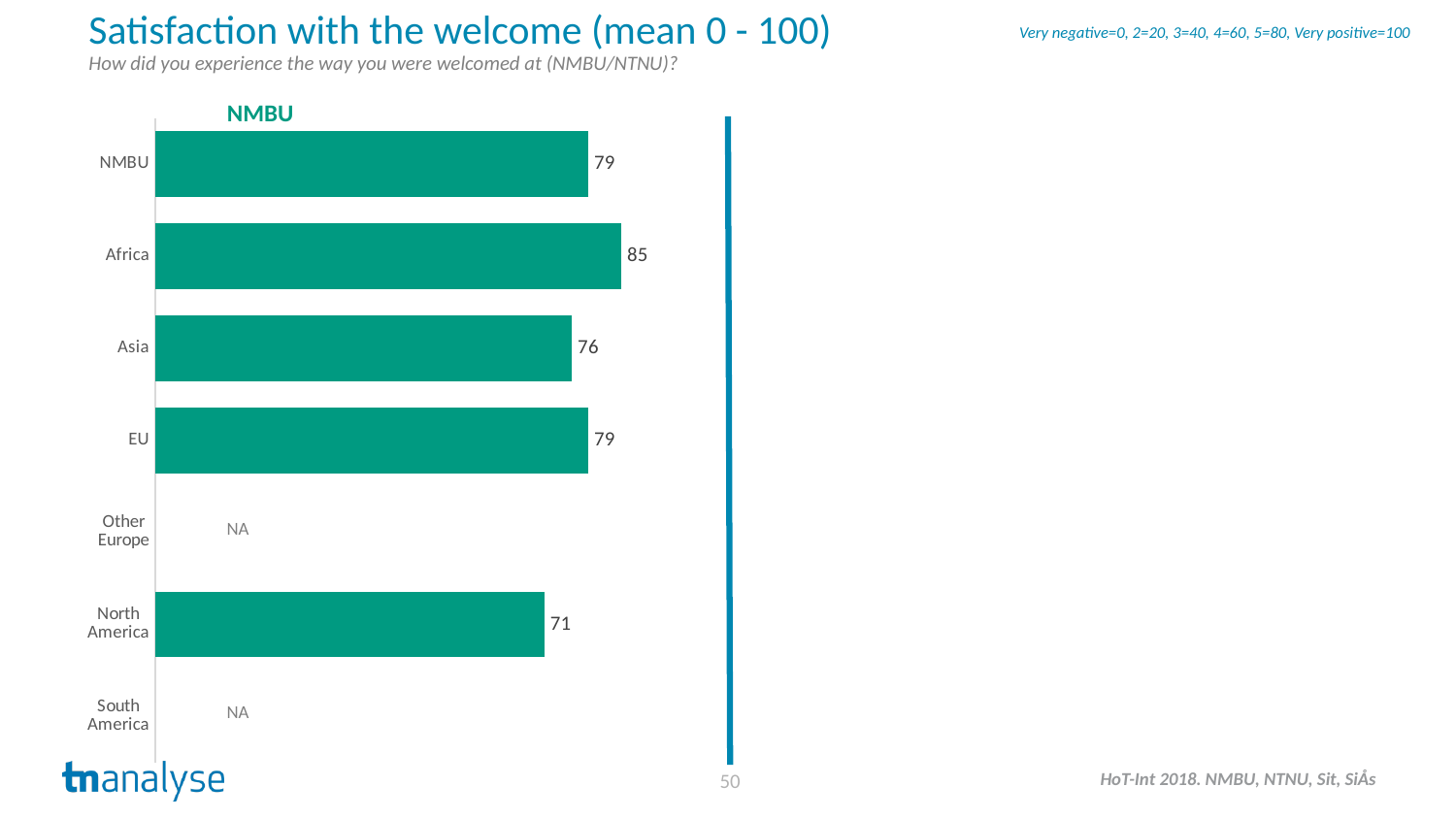
Which is larger, the value for Asia or the value for EU? EU What is the value for Africa? 85 What is the value for North America? 71 What is the value for Asia? 76 What is the series label shown above the bars? NMBU What is the title of the slide? Satisfaction with the welcome (mean 0 - 100) How many categories are listed on the chart? 7 What kind of chart is this? Bar chart Which category has the highest value? Africa What is the difference between the values for Africa and North America? 14 Which category with a plotted bar has the lowest value? North America What is shown for Other Europe? NA